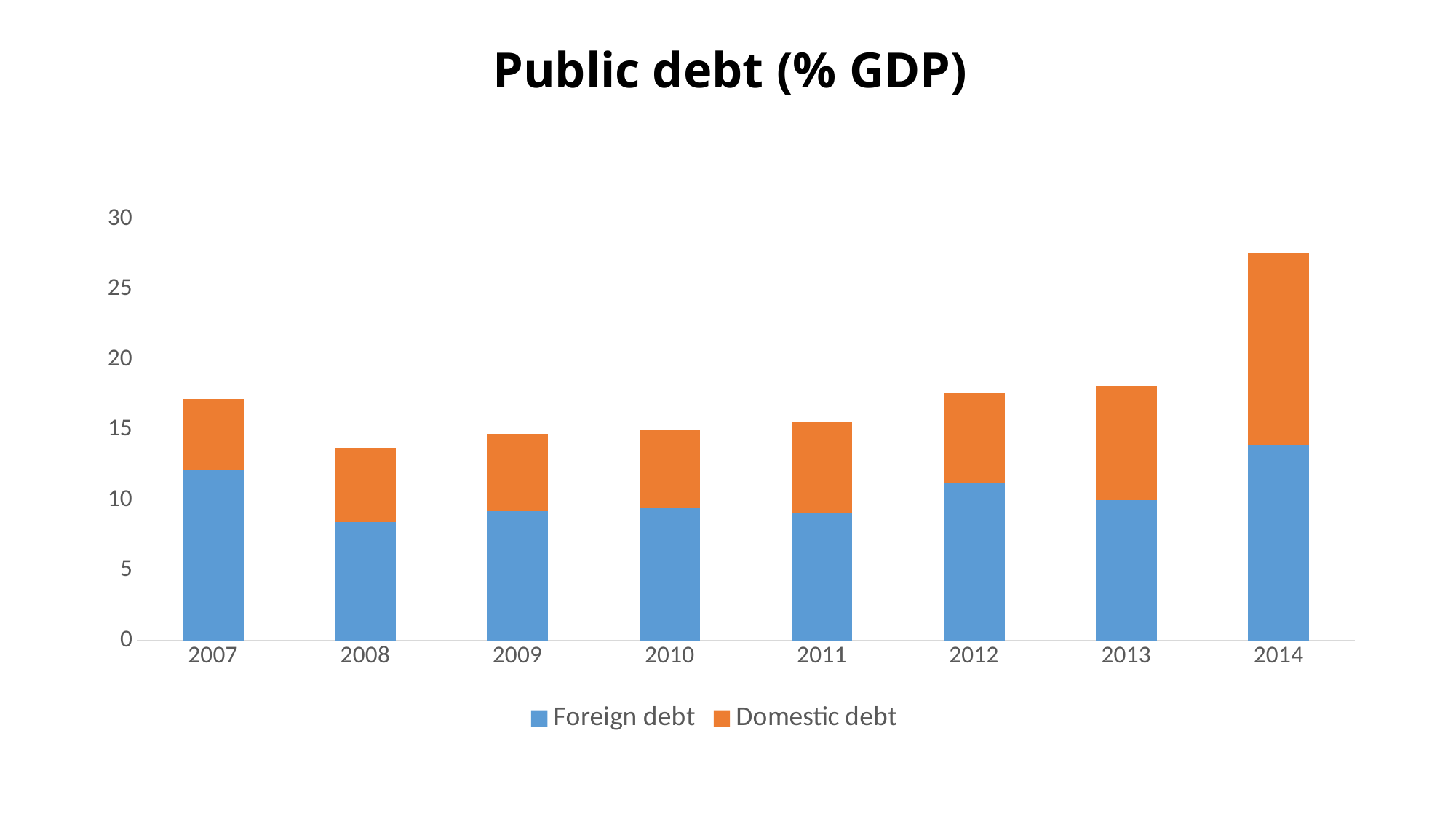
How many series does the legend list? 2 What kind of chart is shown on the slide? Stacked bar chart Is the total public debt for 2008 greater or less than 15? less Is the Foreign debt value for 2007 greater or less than 10? greater Is the Foreign debt value for 2008 greater or less than 10? less What is the title of the chart? Public debt (% GDP) From 2008 to 2014, does the total public debt rise or fall? rise Which year has the lowest total public debt? 2008 Which year has the highest total public debt? 2014 Which is larger, the total public debt in 2007 or in 2014? 2014 How many years are shown on the x axis of the chart? 8